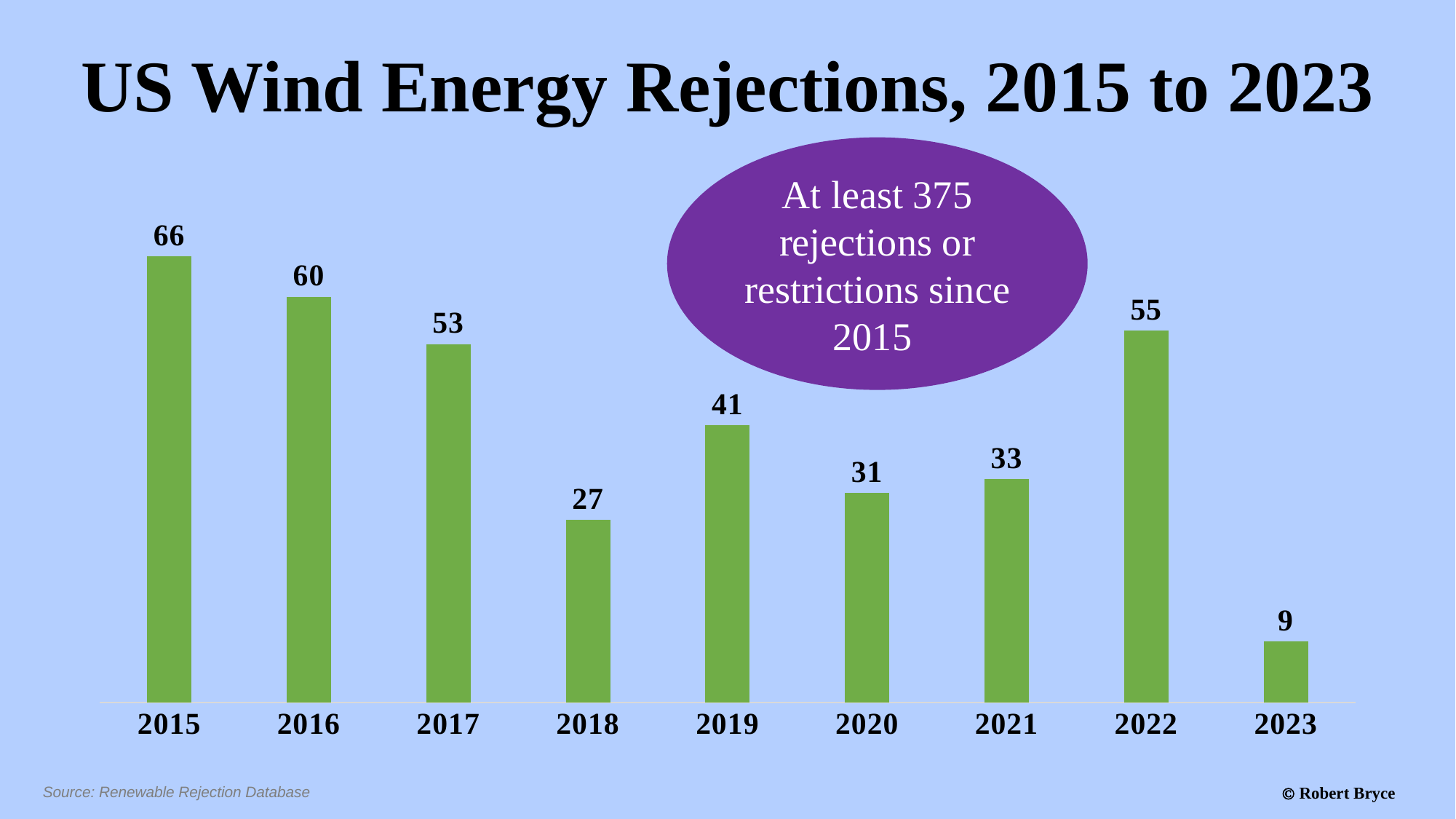
What is the value for 2018? 27 Which is larger, the value for 2019 or the value for 2020? 2019 What is the difference between the values for 2015 and 2023? 57 Which year has the lowest value? 2023 Which year has the highest value? 2015 Do the values rise or fall from 2015 to 2018? fall How many years are shown on the x axis? 9 What kind of chart is this? bar chart What is the value for 2015? 66 What is the value for 2022? 55 What is the title of the chart? US Wind Energy Rejections, 2015 to 2023 What is the difference between the values for 2021 and 2020? 2